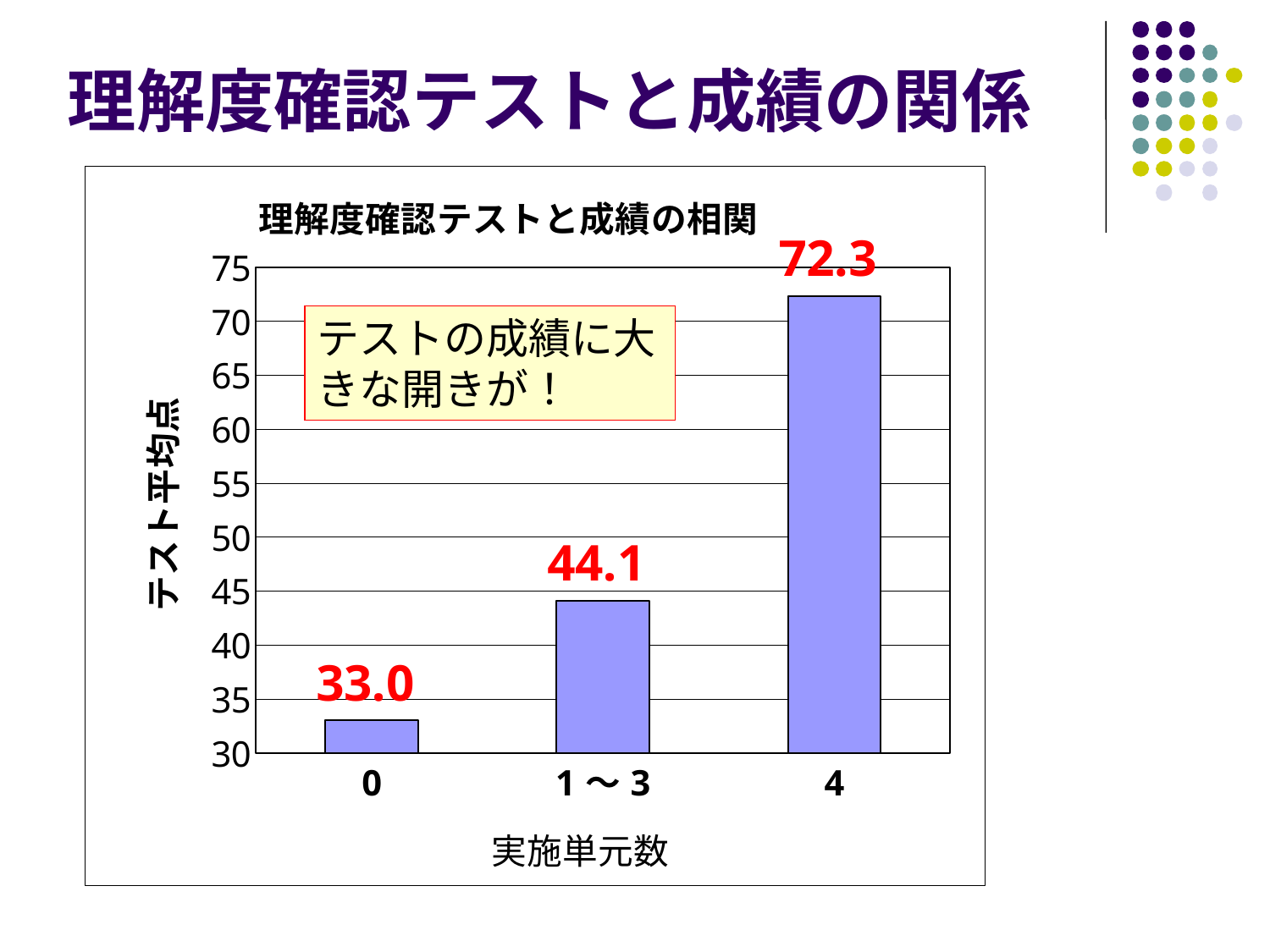
How many categories are shown on the x axis? 3 What is the average test score for the category 1～3? 44.1 Which category has the lowest average test score? 0 What kind of chart is shown on the slide? bar chart Is the value for category 1～3 greater or less than 50? less Which is larger, the average test score for category 1～3 or for category 4? 4 What is the difference between the average test scores for category 4 and category 0? 39.3 Do the values rise or fall from left to right along the x axis? rise What is the difference between the average test scores for category 1～3 and category 0? 11.1 What is the average test score for the category 4? 72.3 What is the average test score for the category 0 (実施単元数)? 33.0 Which category has the highest average test score? 4